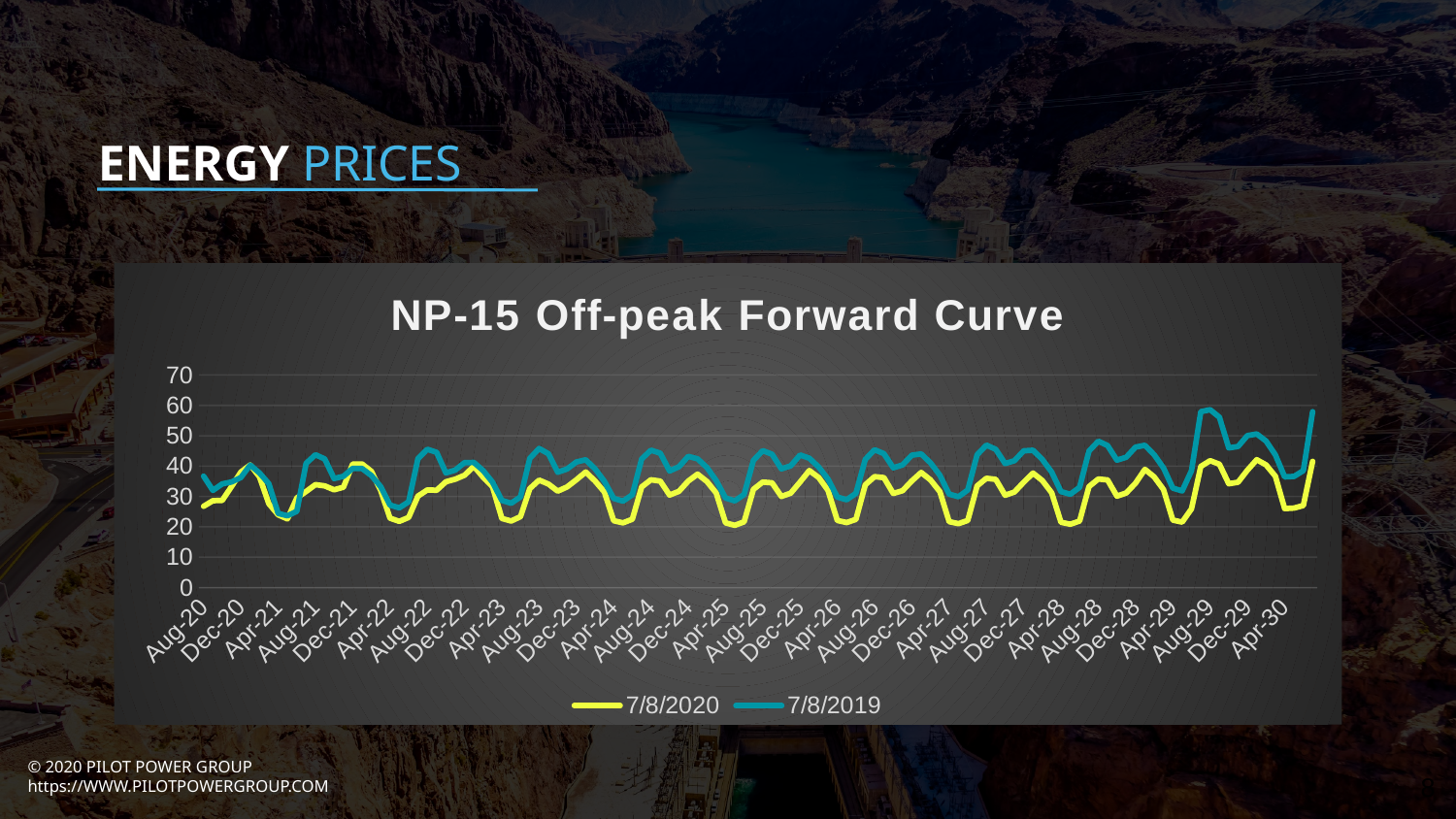
What is the highest value shown on the y axis? 70 Is the 7/8/2019 value at Aug-29 greater or less than 50? greater What type of chart is shown on the slide? Line chart Does the 7/8/2020 series ever rise above 50? No Which series has the higher value at Aug-29, 7/8/2020 or 7/8/2019? 7/8/2019 How many series does the legend list? 2 What is the last label on the x axis? Apr-30 Is the 7/8/2020 value at Aug-20 greater or less than 30? less What is the first label on the x axis? Aug-20 Which series is higher for most of the period, 7/8/2020 or 7/8/2019? 7/8/2019 What is the title of the chart? NP-15 Off-peak Forward Curve Which series is drawn in yellow? 7/8/2020